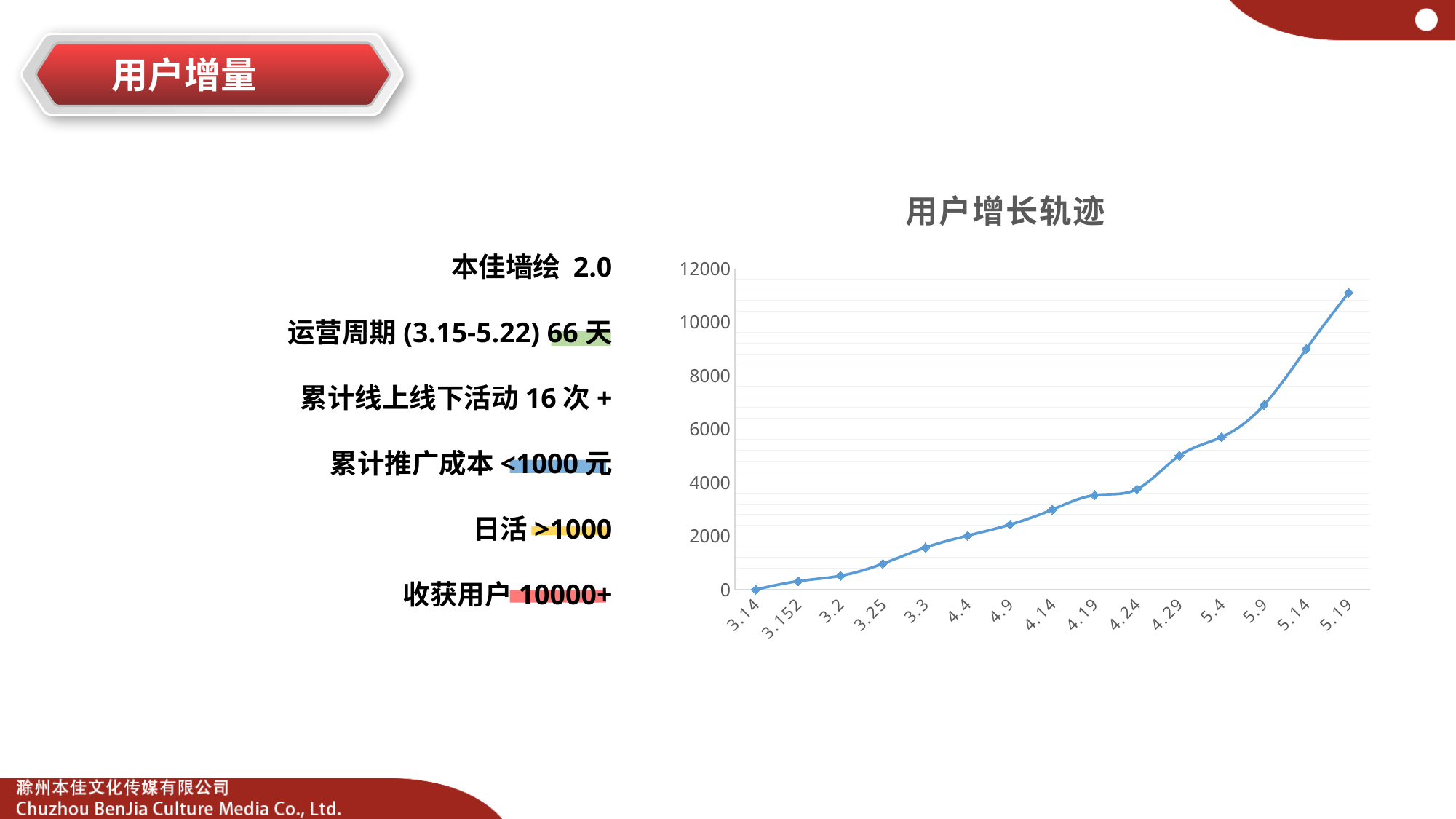
How many data points are plotted on the line? 15 Do the values rise or fall from 3.14 to 5.19 along the x axis? rise Is the value for 5.19 greater or less than 10000? greater What is the title of the chart? 用户增长轨迹 What kind of chart is shown on the slide? line chart Is the value for 4.29 greater or less than 4000? greater Which date has the lowest value on the chart? 3.14 Which has the larger value, 5.14 or 4.29? 5.14 Which has the larger value, 3.3 or 4.19? 4.19 Which date has the highest value on the chart? 5.19 Is the value for 5.14 greater or less than 8000? greater